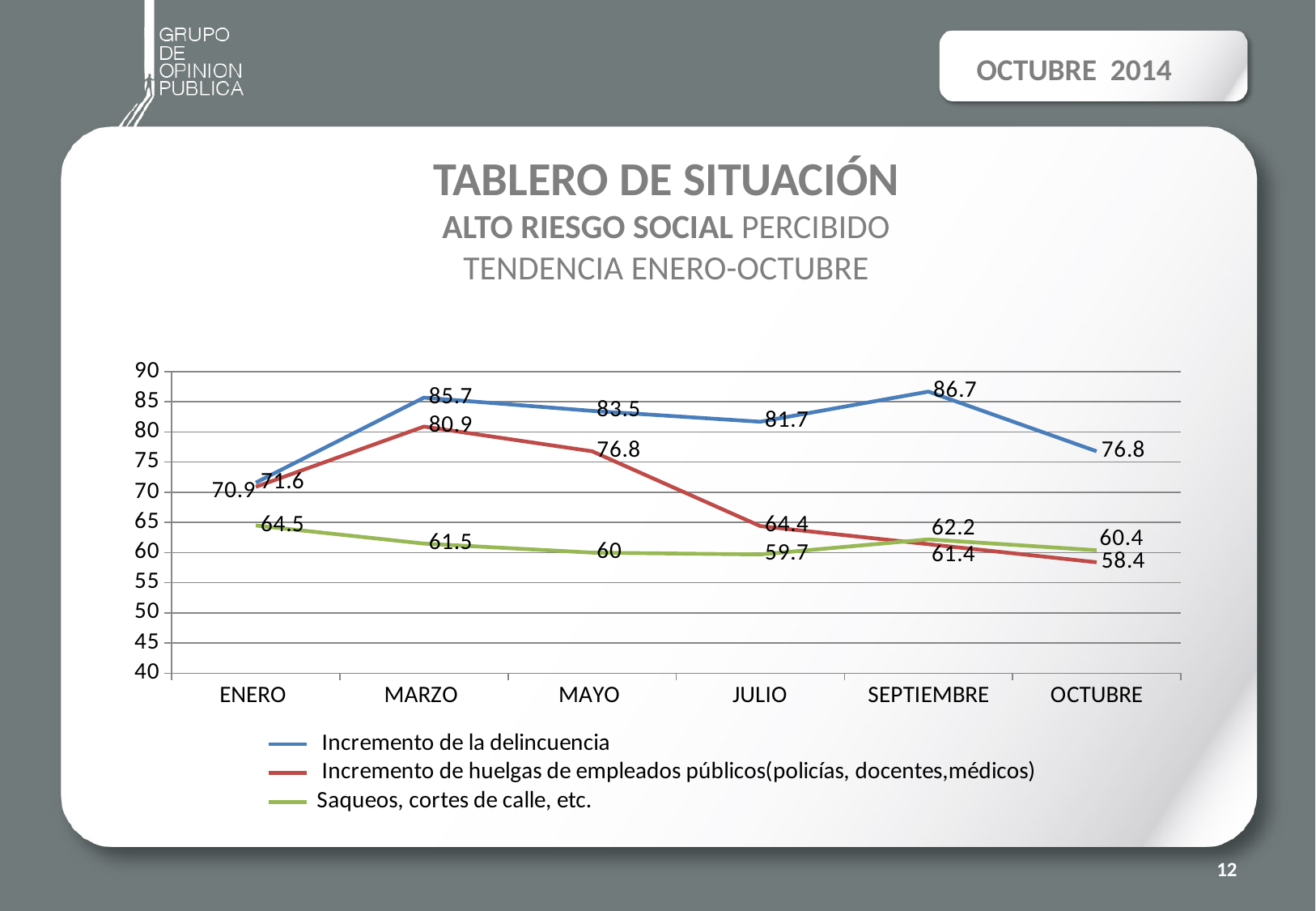
Does 'Incremento de huelgas de empleados públicos' rise or fall from MARZO to OCTUBRE? fall What colour is the line for 'Saqueos, cortes de calle, etc.'? green What kind of chart is shown on the slide? line chart How many months are shown on the x axis? 6 How many series does the legend list? 3 In which month does 'Incremento de la delincuencia' reach its highest value? SEPTIEMBRE In OCTUBRE, which is larger: 'Saqueos, cortes de calle, etc.' or 'Incremento de huelgas de empleados públicos'? Saqueos, cortes de calle, etc. What is the value for 'Saqueos, cortes de calle, etc.' in ENERO? 64.5 What is the value for 'Incremento de la delincuencia' in SEPTIEMBRE? 86.7 What is the value for 'Incremento de huelgas de empleados públicos' in JULIO? 64.4 In which month does 'Incremento de huelgas de empleados públicos' reach its lowest value? OCTUBRE What is the difference between 'Incremento de la delincuencia' and 'Incremento de huelgas de empleados públicos' in MARZO? 4.8